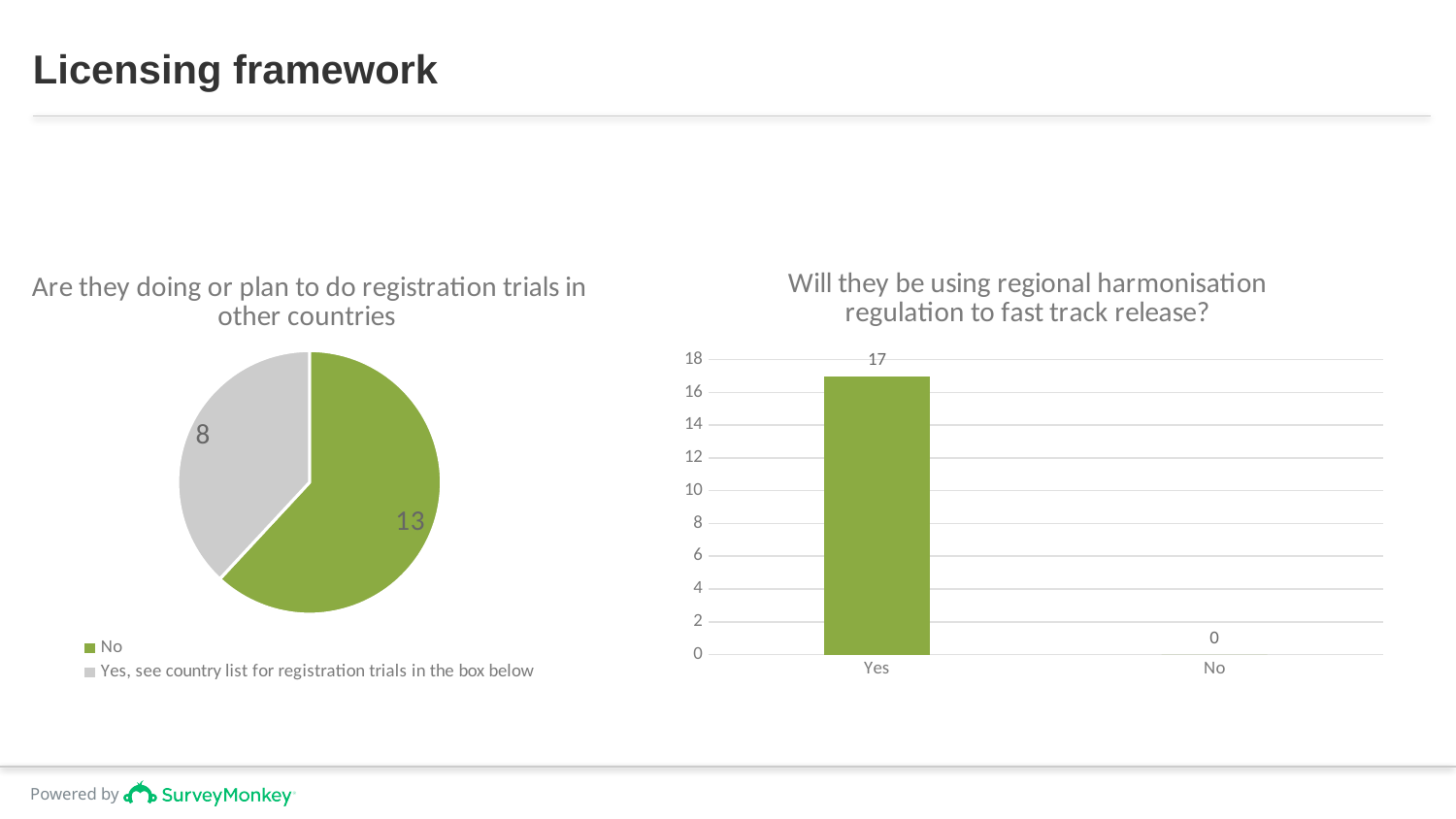
How many entries does the legend of the pie chart on the left list? 2 In the bar chart on the right, which category has the lowest value? No In the pie chart on the left, what is the value for 'Yes, see country list for registration trials in the box below'? 8 In the pie chart on the left, which category has the larger slice? No How many categories are shown on the x axis of the bar chart on the right? 2 What kind of chart is the chart on the right of the slide? Bar chart What kind of chart is the chart on the left of the slide? Pie chart In the bar chart titled 'Will they be using regional harmonisation regulation to fast track release?', what is the value for 'Yes'? 17 In the pie chart titled 'Are they doing or plan to do registration trials in other countries', what is the value for 'No'? 13 In the bar chart on the right, is the value for 'Yes' greater or less than 16? greater In the bar chart on the right, what is the value for 'No'? 0 In the pie chart on the left, what is the difference between the 'No' value and the 'Yes' value? 5